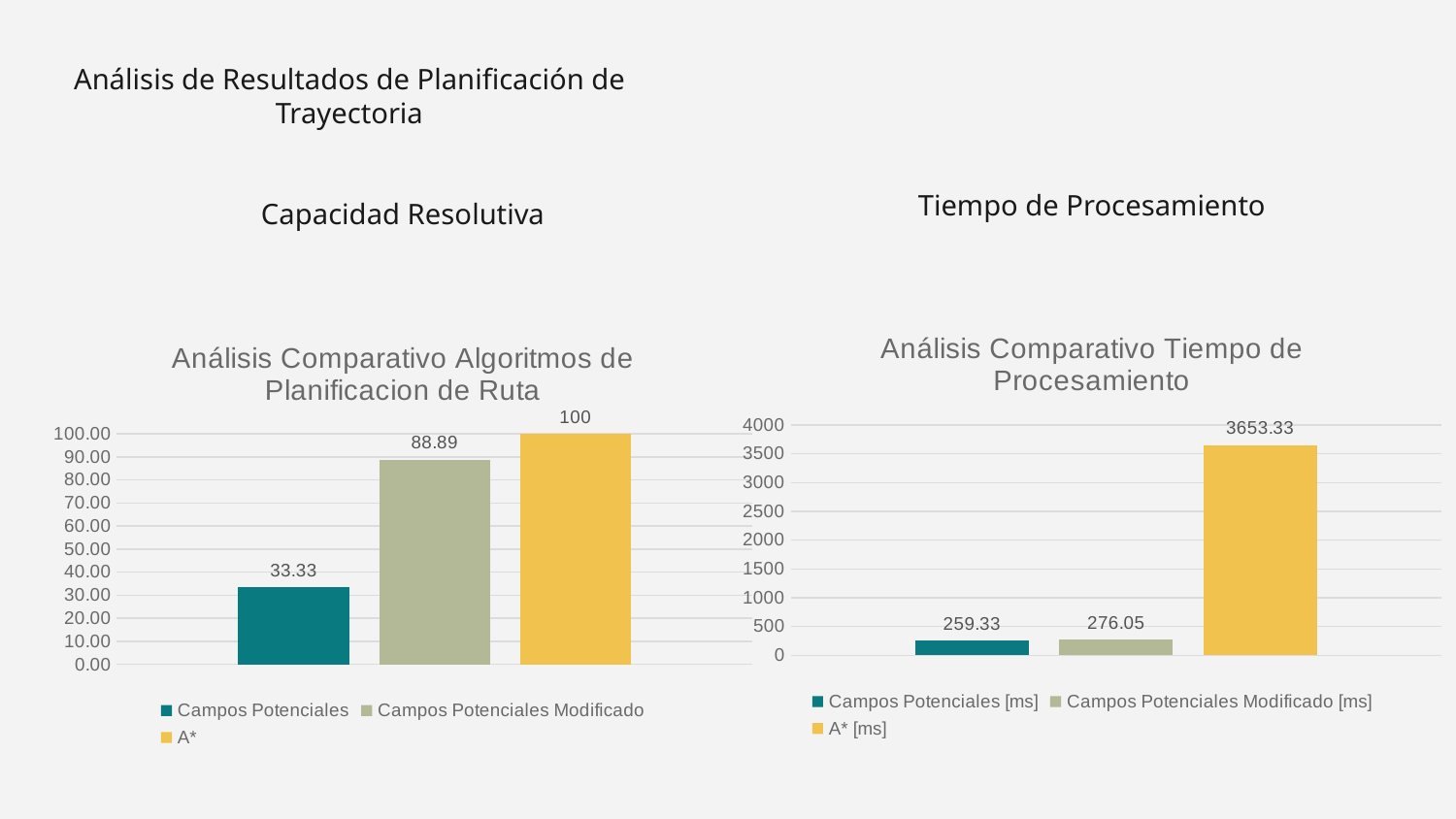
In the chart titled 'Análisis Comparativo Algoritmos de Planificacion de Ruta', how many series does the legend list? 3 In the chart titled 'Análisis Comparativo Algoritmos de Planificacion de Ruta', what is the value for Campos Potenciales Modificado? 88.89 In the chart titled 'Análisis Comparativo Algoritmos de Planificacion de Ruta', what is the value for Campos Potenciales? 33.33 In the chart titled 'Análisis Comparativo Algoritmos de Planificacion de Ruta', what colour is the bar for A*? yellow In the chart titled 'Análisis Comparativo Algoritmos de Planificacion de Ruta', what is the difference between the values for A* and Campos Potenciales? 66.67 In the chart titled 'Análisis Comparativo Tiempo de Procesamiento', what is the difference between the values for Campos Potenciales Modificado [ms] and Campos Potenciales [ms]? 16.72 In the chart titled 'Análisis Comparativo Tiempo de Procesamiento', which series has the lowest value? Campos Potenciales [ms] In the chart titled 'Análisis Comparativo Tiempo de Procesamiento', what is the value for Campos Potenciales [ms]? 259.33 In the chart titled 'Análisis Comparativo Tiempo de Procesamiento', what is the value for A* [ms]? 3653.33 In the chart titled 'Análisis Comparativo Algoritmos de Planificacion de Ruta', which series has the highest value? A* What kind of chart is the chart titled 'Análisis Comparativo Tiempo de Procesamiento'? bar chart In the chart titled 'Análisis Comparativo Tiempo de Procesamiento', is the value for A* [ms] greater or less than 3500? greater